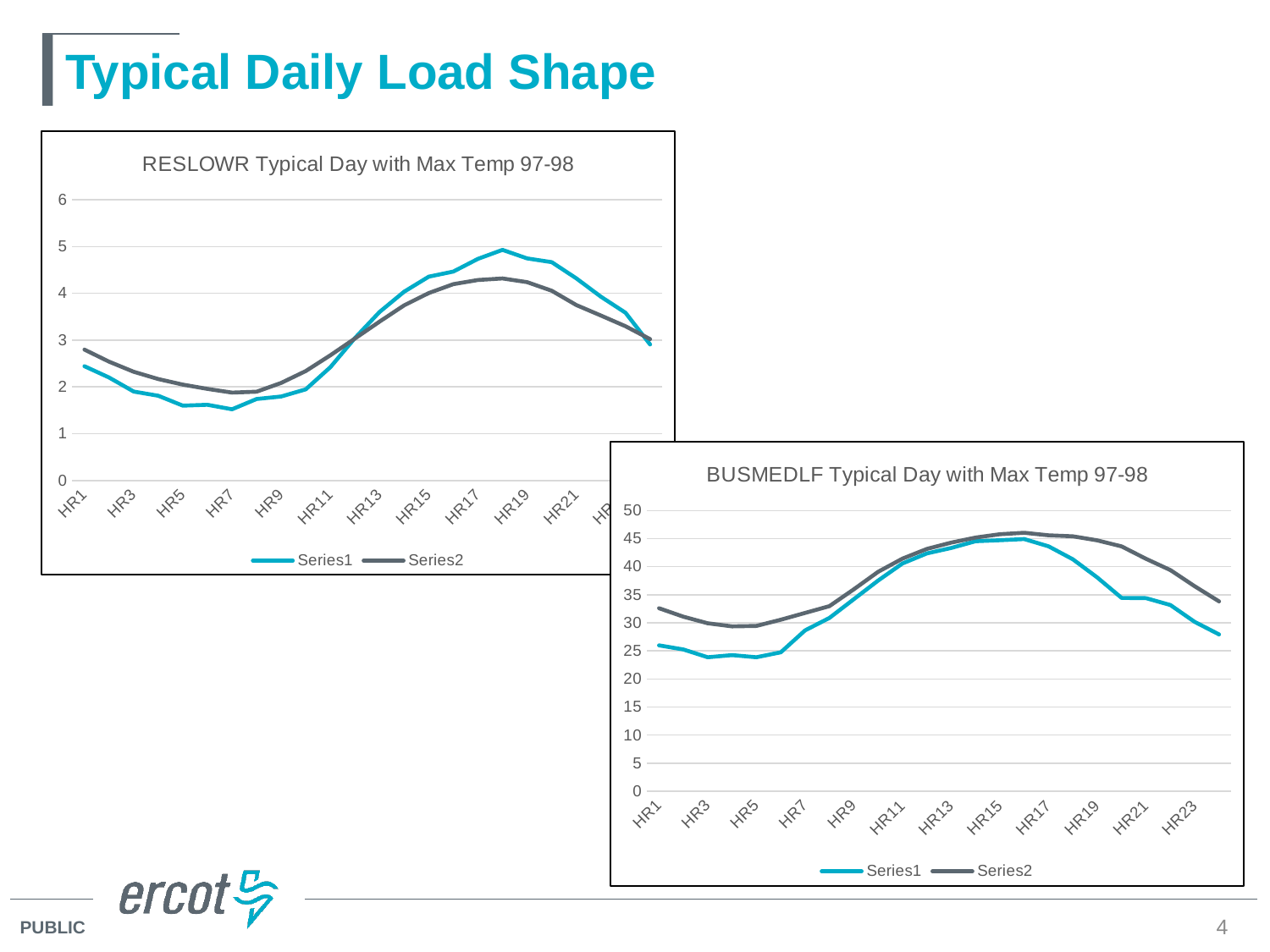
How many series does the legend of the BUSMEDLF Typical Day with Max Temp 97-98 chart list? 2 In the RESLOWR Typical Day with Max Temp 97-98 chart, is the Series1 value at HR7 greater or less than 2? less What type of chart is the RESLOWR Typical Day with Max Temp 97-98 chart? line chart In the RESLOWR Typical Day with Max Temp 97-98 chart, which series has the larger value at HR19, Series1 or Series2? Series1 In the RESLOWR Typical Day with Max Temp 97-98 chart, at which hour does Series1 reach its highest value? HR18 In the RESLOWR Typical Day with Max Temp 97-98 chart, does Series1 rise or fall from HR7 to HR19? rise In the BUSMEDLF Typical Day with Max Temp 97-98 chart, does Series1 rise or fall from HR17 to HR23? fall In the RESLOWR Typical Day with Max Temp 97-98 chart, is the Series1 value at HR19 greater or less than 4? greater What is the title of the chart in the lower right of the slide? BUSMEDLF Typical Day with Max Temp 97-98 In the BUSMEDLF Typical Day with Max Temp 97-98 chart, which series has the larger value at HR21, Series1 or Series2? Series2 In the BUSMEDLF Typical Day with Max Temp 97-98 chart, is the Series2 value at HR13 greater or less than 40? greater